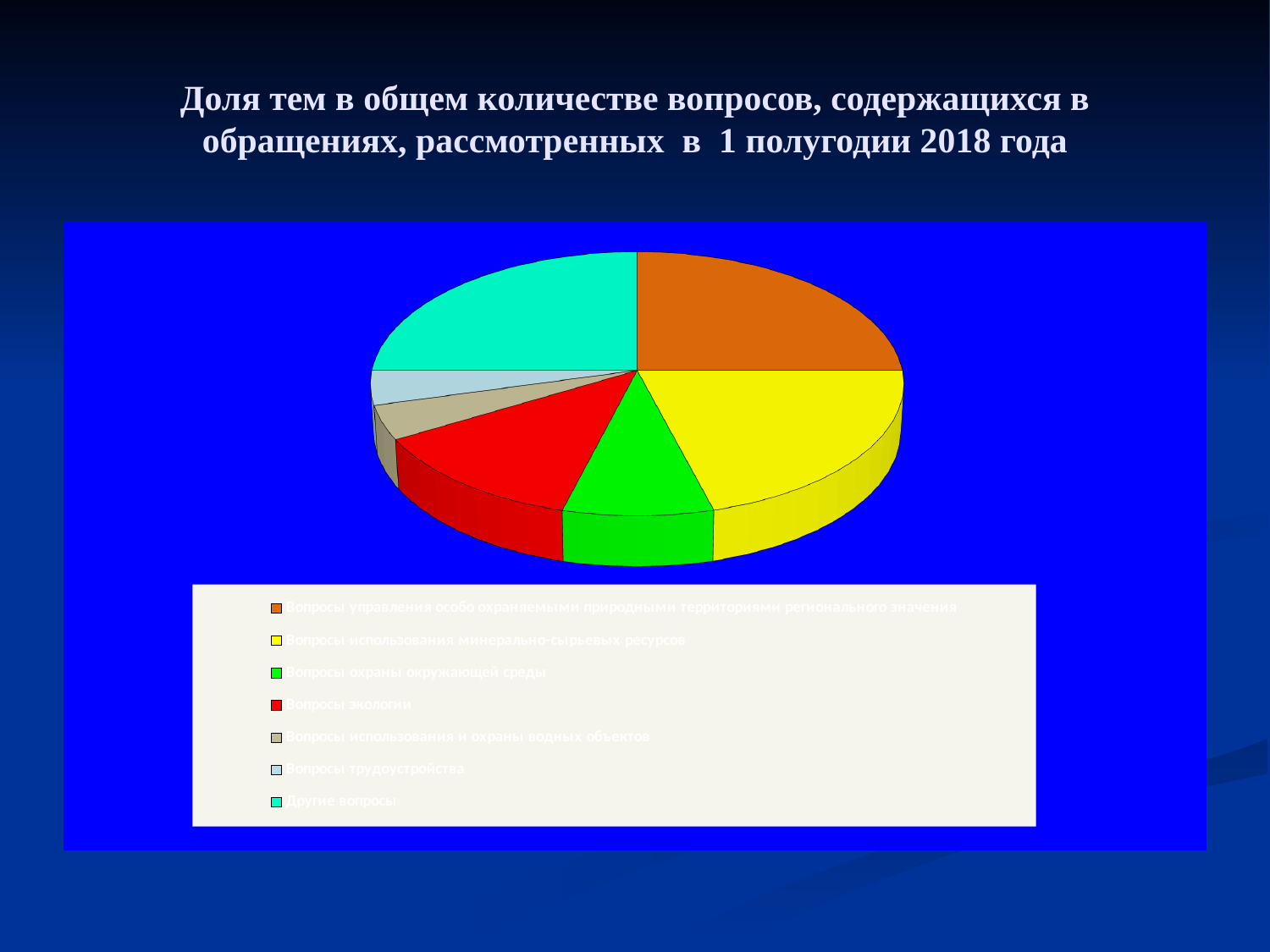
What colour is the slice for Другие вопросы? Cyan Which slice is larger: Вопросы использования минерально-сырьевых ресурсов or Вопросы охраны окружающей среды? Вопросы использования минерально-сырьевых ресурсов How many entries does the legend list? 7 How many slices does the pie chart have? 7 What kind of chart is shown on the slide? Pie chart What is the title of the slide containing the pie chart? Доля тем в общем количестве вопросов, содержащихся в обращениях, рассмотренных в 1 полугодии 2018 года Which slice is larger: Вопросы экологии or Вопросы охраны окружающей среды? Вопросы экологии Which slice is larger: Вопросы управления особо охраняемыми природными территориями регионального значения or Вопросы использования и охраны водных объектов? Вопросы управления особо охраняемыми природными территориями регионального значения